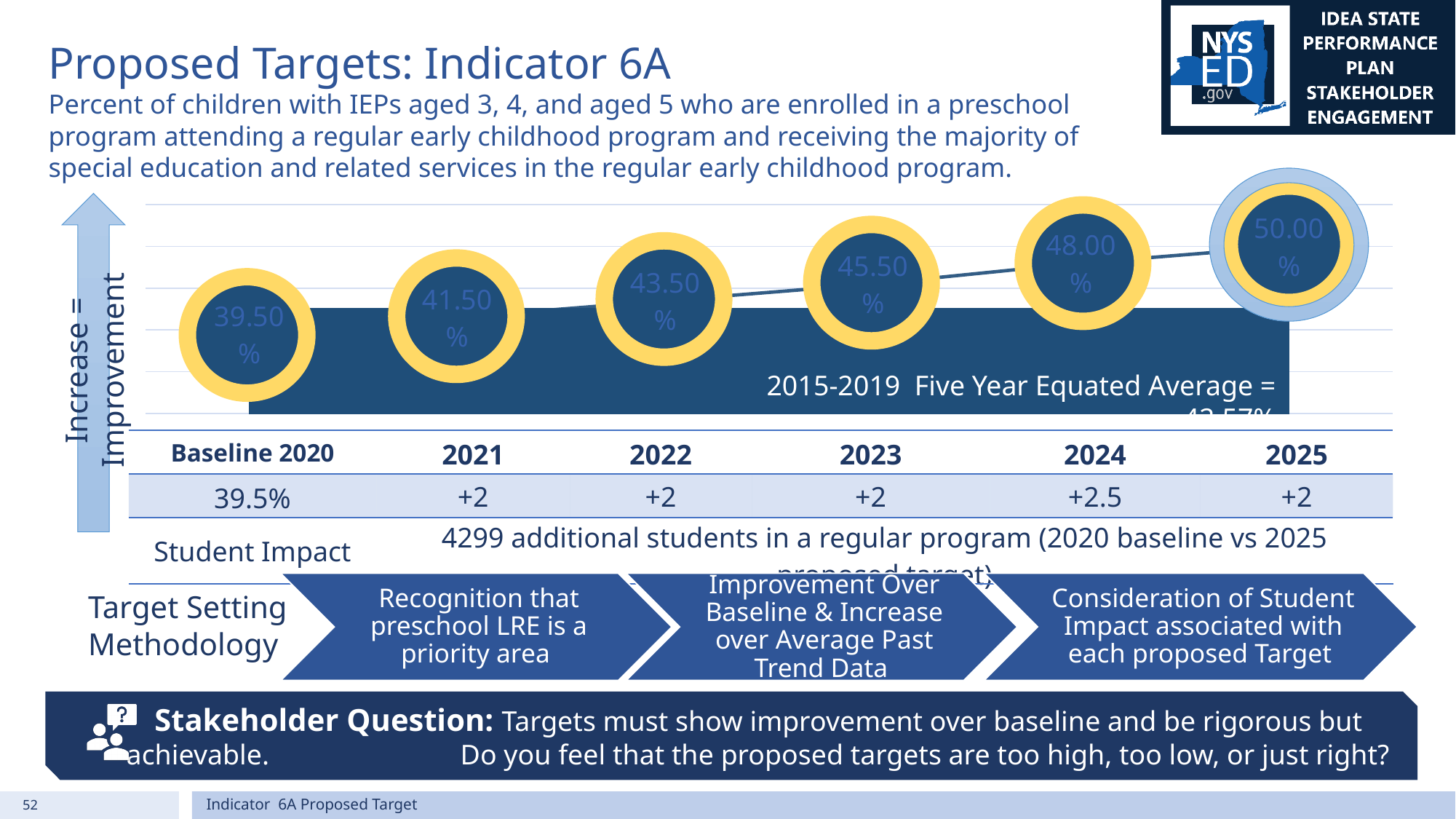
Which is larger, the value for 2022 or the value for 2021? 2022 Which year has the highest plotted value? 2025 What is the value shown for Baseline 2020? 39.50% What is the difference between the 2024 and 2023 target values? 2.5 percentage points How many data points are plotted on the chart? 6 What is the proposed target value for 2023? 45.50% What is the 2015-2019 Five Year Equated Average shown on the chart? 42.57% Which year has the lowest plotted value? Baseline 2020 What is the proposed target value for 2025? 50.00% What is the proposed target value for 2024? 48.00% What is the difference between the 2025 target and the Baseline 2020 value? 10.5 percentage points Do the plotted values rise or fall from Baseline 2020 to 2025? Rise